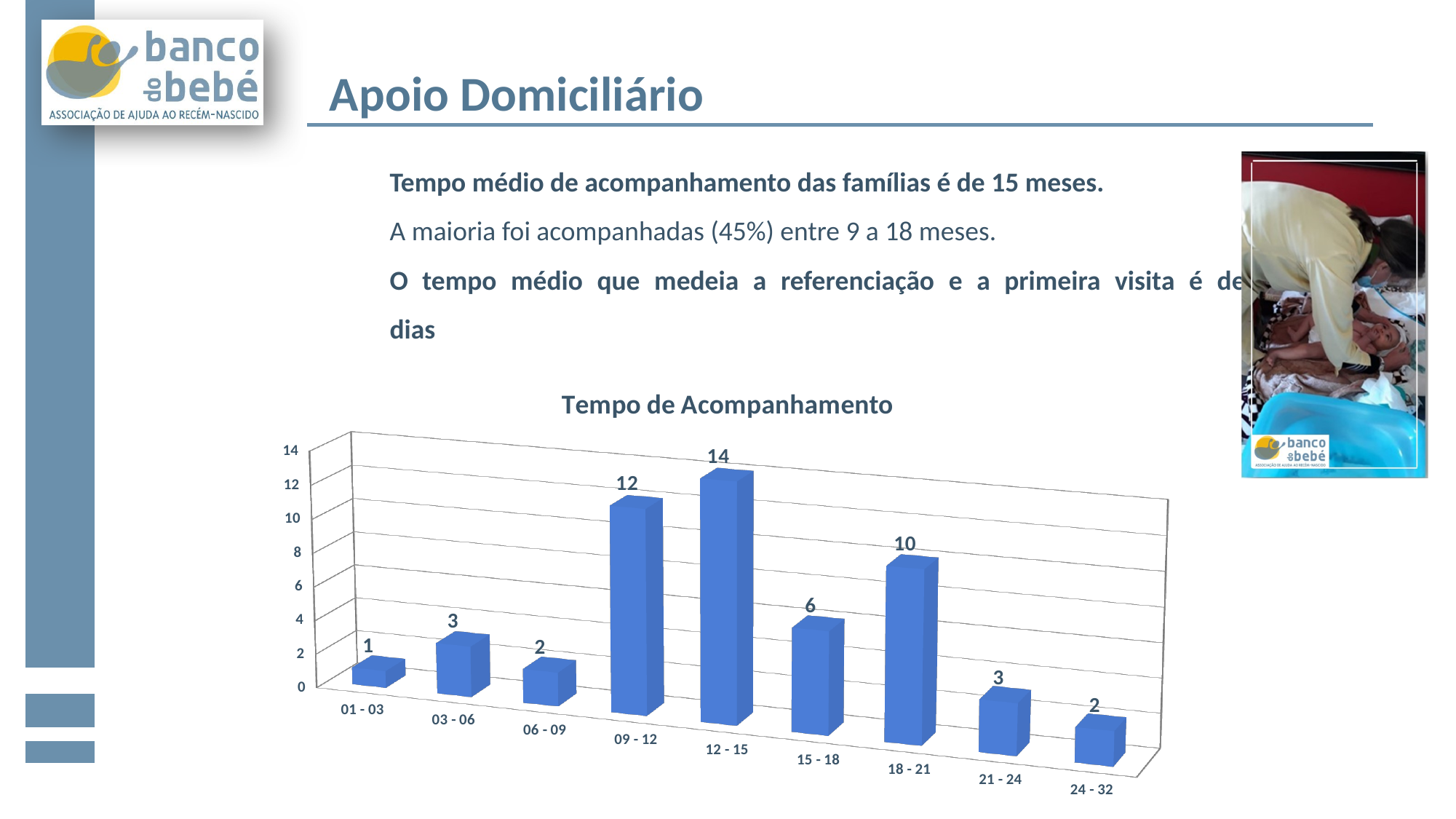
What is the value for the 01 - 03 category? 1 What is the title of the chart? Tempo de Acompanhamento What is the value for the 09 - 12 category? 12 What kind of chart is shown on the slide? bar chart Which category has the highest value? 12 - 15 What is the difference between the values for 12 - 15 and 18 - 21? 4 What is the value for the 18 - 21 category? 10 Which is larger, the value for 15 - 18 or the value for 03 - 06? 15 - 18 Is the value for 09 - 12 greater or less than 10? greater How many categories are shown on the x axis? 9 Which category has the lowest value? 01 - 03 What is the value for the 12 - 15 category in the Tempo de Acompanhamento chart? 14